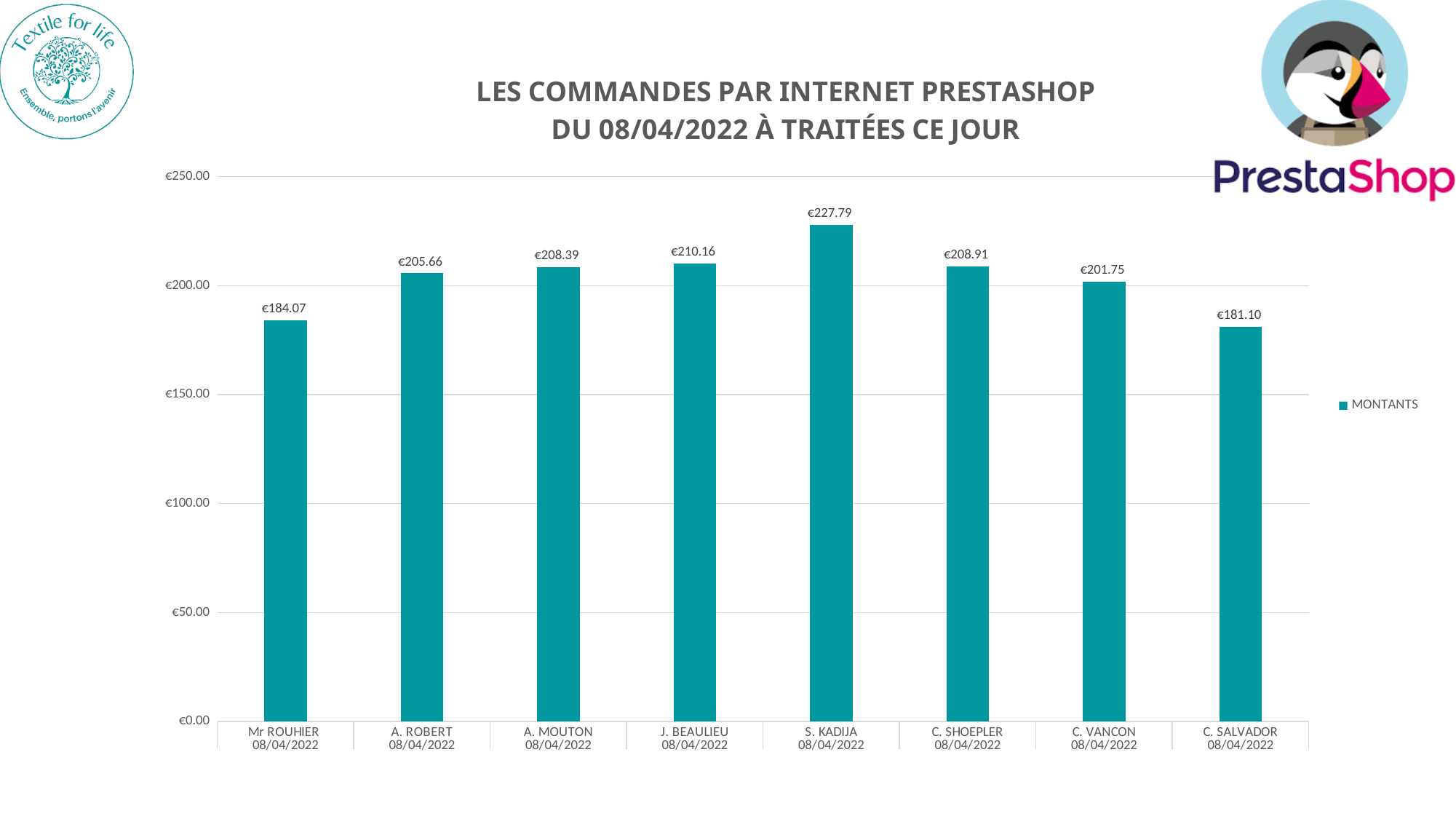
What is the value for S. KADIJA? €227.79 How many series does the legend list? 1 What is the value for Mr ROUHIER? €184.07 Is the value for C. SALVADOR greater or less than €200.00? less What is the value for C. VANCON? €201.75 Which category has the lowest value? C. SALVADOR What is the name of the series shown in the legend? MONTANTS What is the difference between the values for S. KADIJA and C. SALVADOR? €46.69 Which is larger, the value for A. ROBERT or the value for J. BEAULIEU? J. BEAULIEU How many categories are shown on the x axis? 8 Which category has the highest value? S. KADIJA What kind of chart is shown on the slide? bar chart